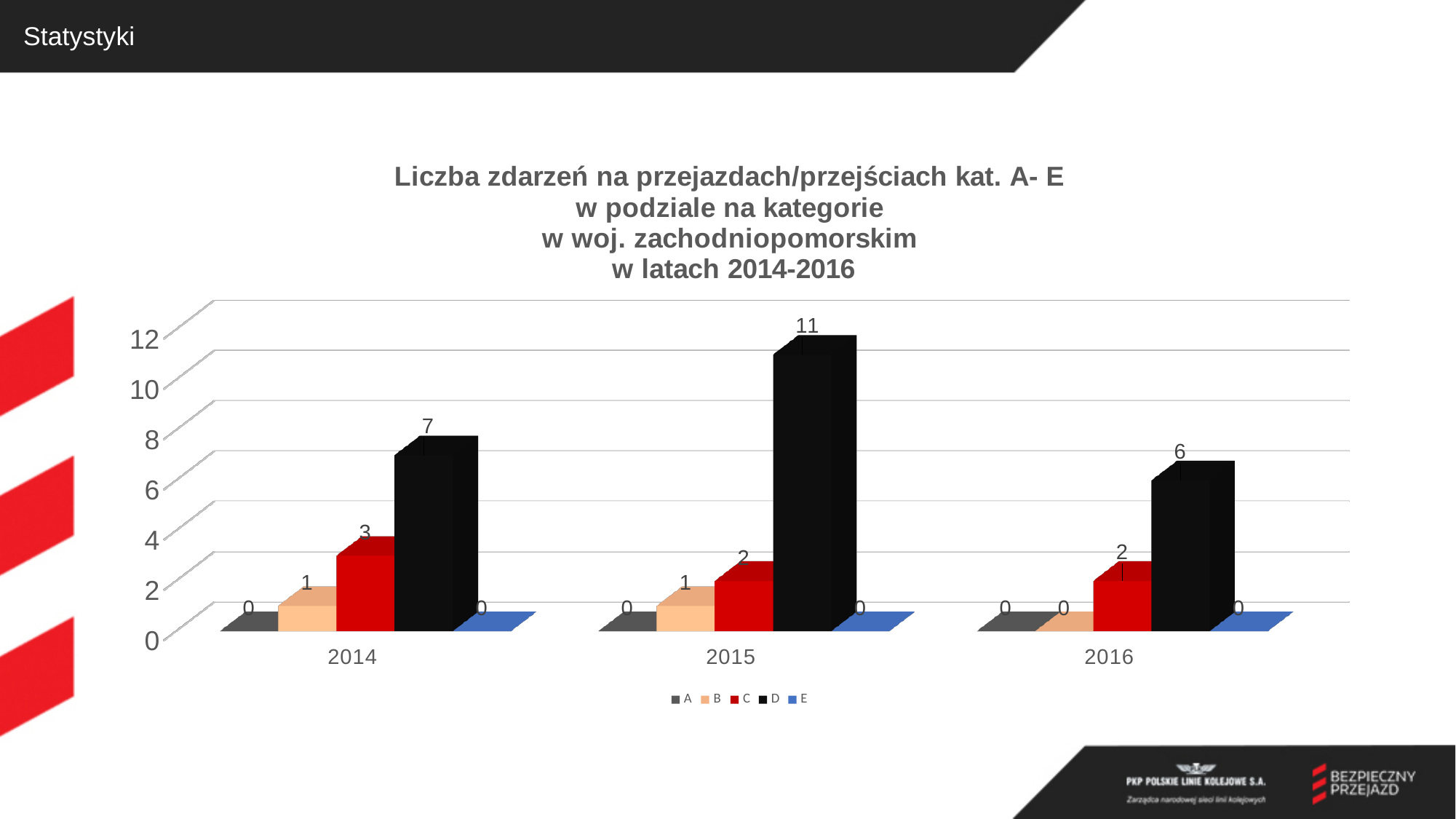
What is the value for category B in 2016? 0 In which year is the value for category D the highest? 2015 What colour are the bars for category C? red What kind of chart is shown on the slide? bar chart How many years are shown on the x axis? 3 In which year is the value for category D the lowest? 2016 What is the value for category C in 2014? 3 What is the difference between the value for category D in 2015 and in 2014? 4 How many series does the legend list? 5 Which is larger: the value for category C in 2014 or in 2015? 2014 What is the value for category D in 2015? 11 What is the value for category D in 2016? 6